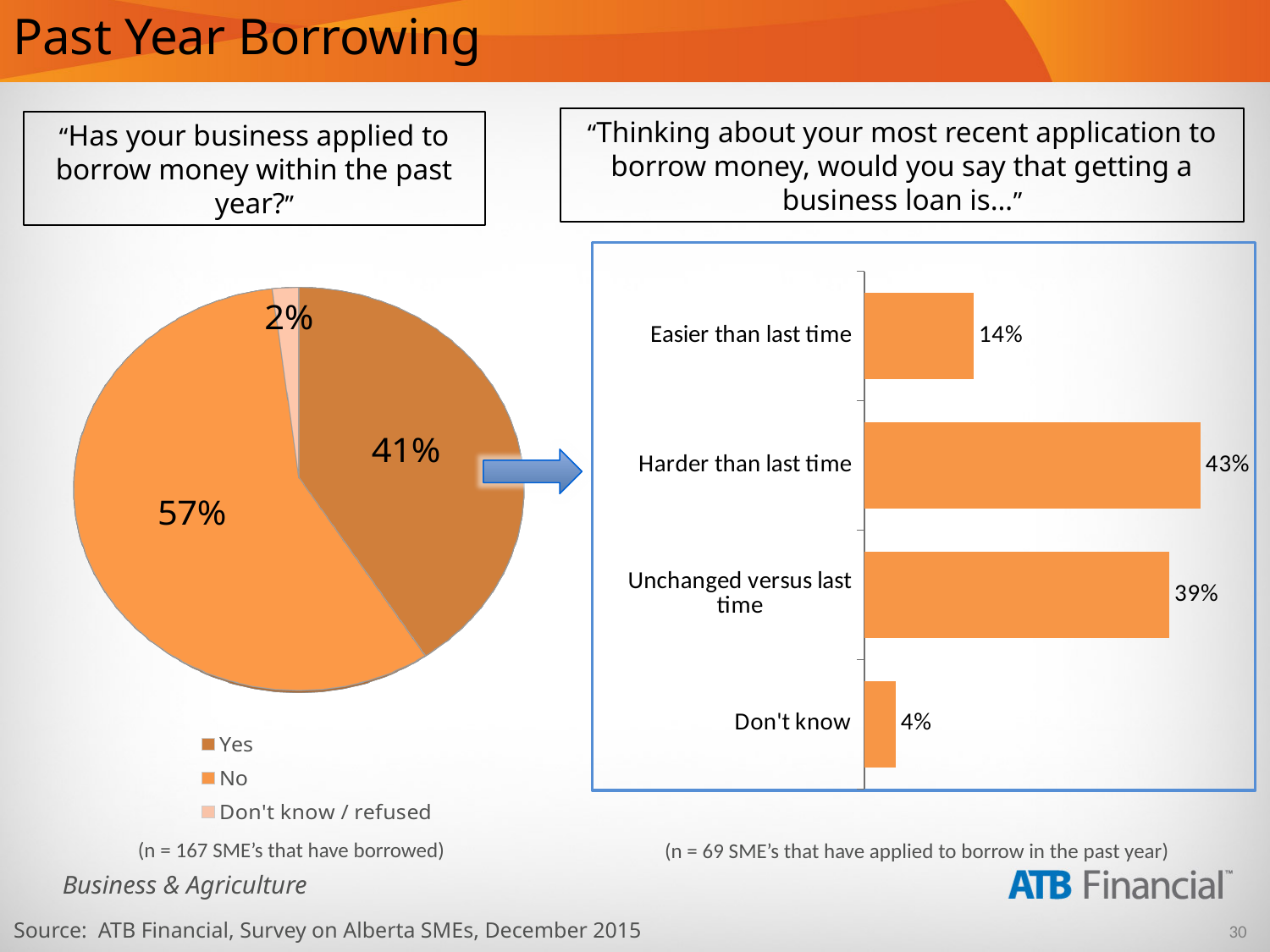
In the pie chart on the left, what share of respondents answered Yes? 41% In the pie chart on the left, how many slices are there? 3 In the bar chart on the right, what is the difference between Harder than last time and Unchanged versus last time? 4% In the bar chart on the right, which is larger: Easier than last time or Unchanged versus last time? Unchanged versus last time In the bar chart on the right, what is the value for Easier than last time? 14% In the bar chart on the right, which category has the lowest value? Don't know In the bar chart on the right, how many categories are shown? 4 In the bar chart on the right, what is the value for Harder than last time? 43% In the pie chart on the left, what share of respondents answered No? 57% In the pie chart on the left, which response has the largest slice? No What kind of chart is shown on the right side of the slide? Bar chart In the pie chart on the left, what share of respondents answered Don't know / refused? 2%